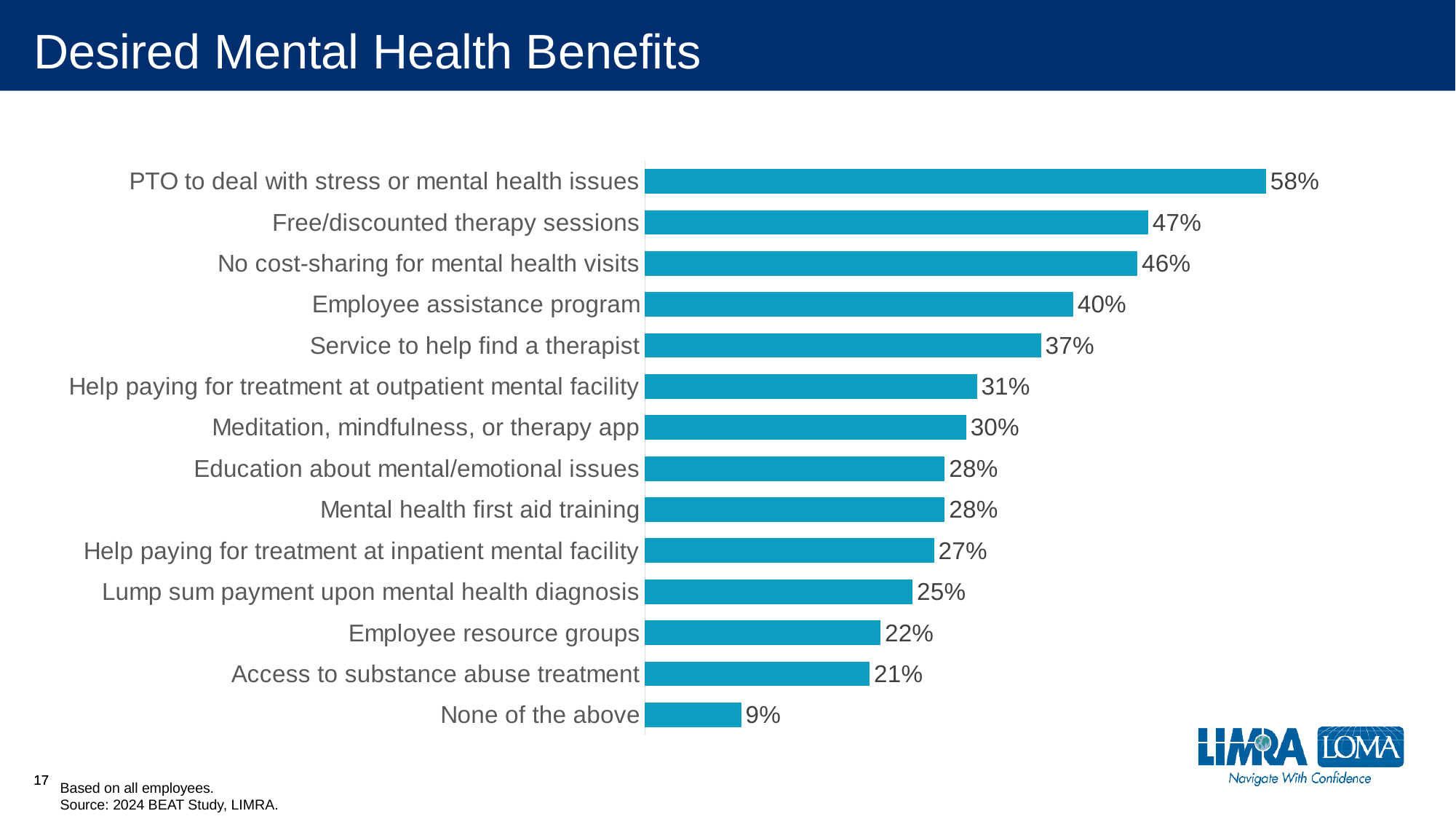
Which benefit has the highest value on the chart? PTO to deal with stress or mental health issues Which is larger: Meditation, mindfulness, or therapy app or Lump sum payment upon mental health diagnosis? Meditation, mindfulness, or therapy app What is the difference between PTO to deal with stress or mental health issues and None of the above? 49% What is the value for Employee assistance program? 40% What percentage of employees desire PTO to deal with stress or mental health issues? 58% What is the title of the slide? Desired Mental Health Benefits What is the difference between Free/discounted therapy sessions and Service to help find a therapist? 10% What kind of chart is shown on the slide? Bar chart Which category has the lowest value on the chart? None of the above What is the value for Access to substance abuse treatment? 21% How many categories are shown on the chart? 14 What is the source cited for the chart data? 2024 BEAT Study, LIMRA